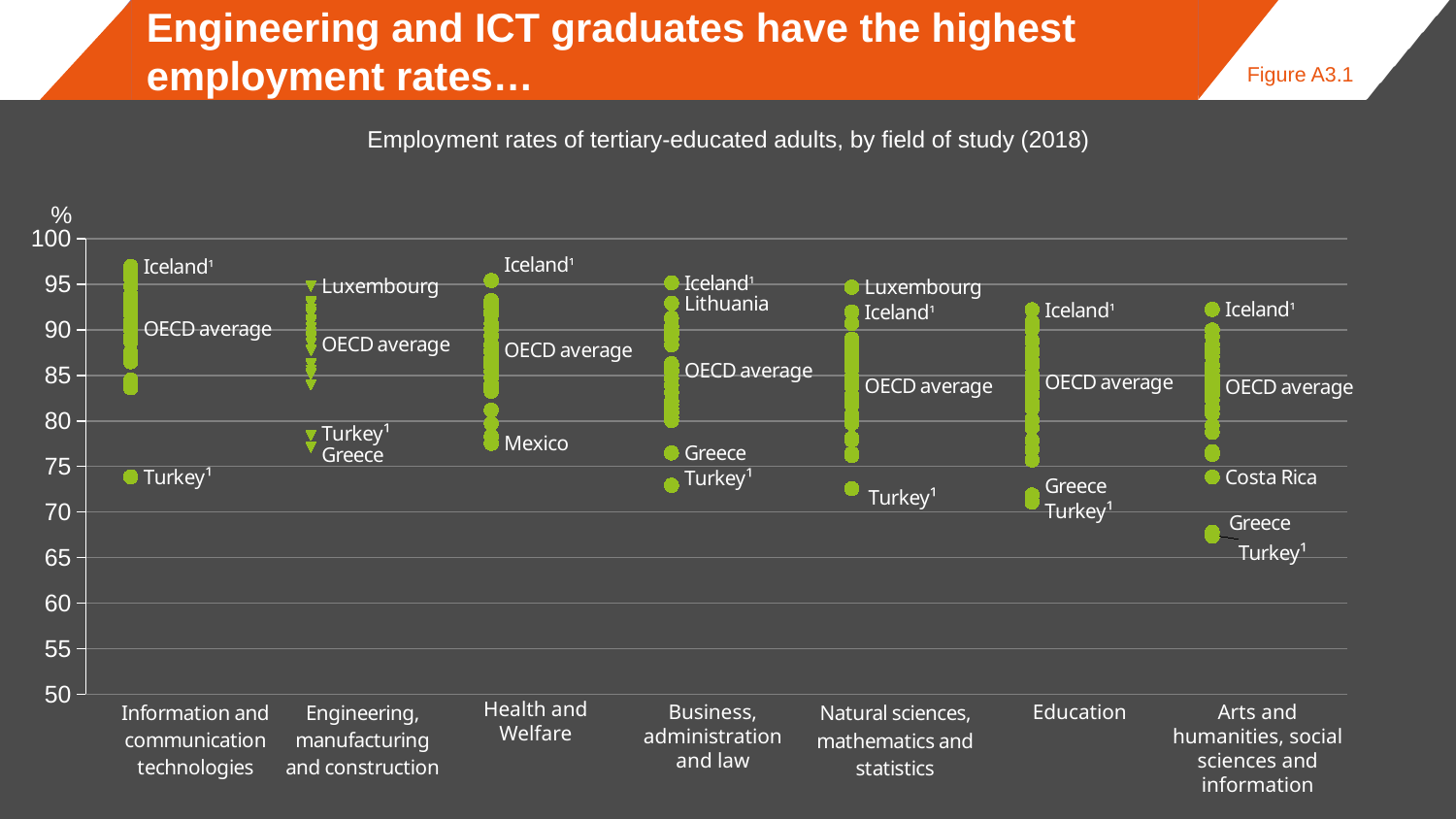
Which field of study has the highest plotted value overall? Information and communication technologies Which field of study has the lowest plotted value overall? Arts and humanities, social sciences and information Is the value for Iceland in Information and communication technologies greater or less than 95? greater Is the value for Greece in Business, administration and law greater or less than 75? greater Which is higher: Iceland's value in Information and communication technologies or Iceland's value in Education? Information and communication technologies Is the value for Turkey in Arts and humanities, social sciences and information greater or less than 70? less Which country is labelled as the lowest point in Health and Welfare? Mexico How many fields of study are shown along the x axis? 7 What is the title of the chart? Employment rates of tertiary-educated adults, by field of study (2018) What kind of chart is this? Dot (scatter) chart